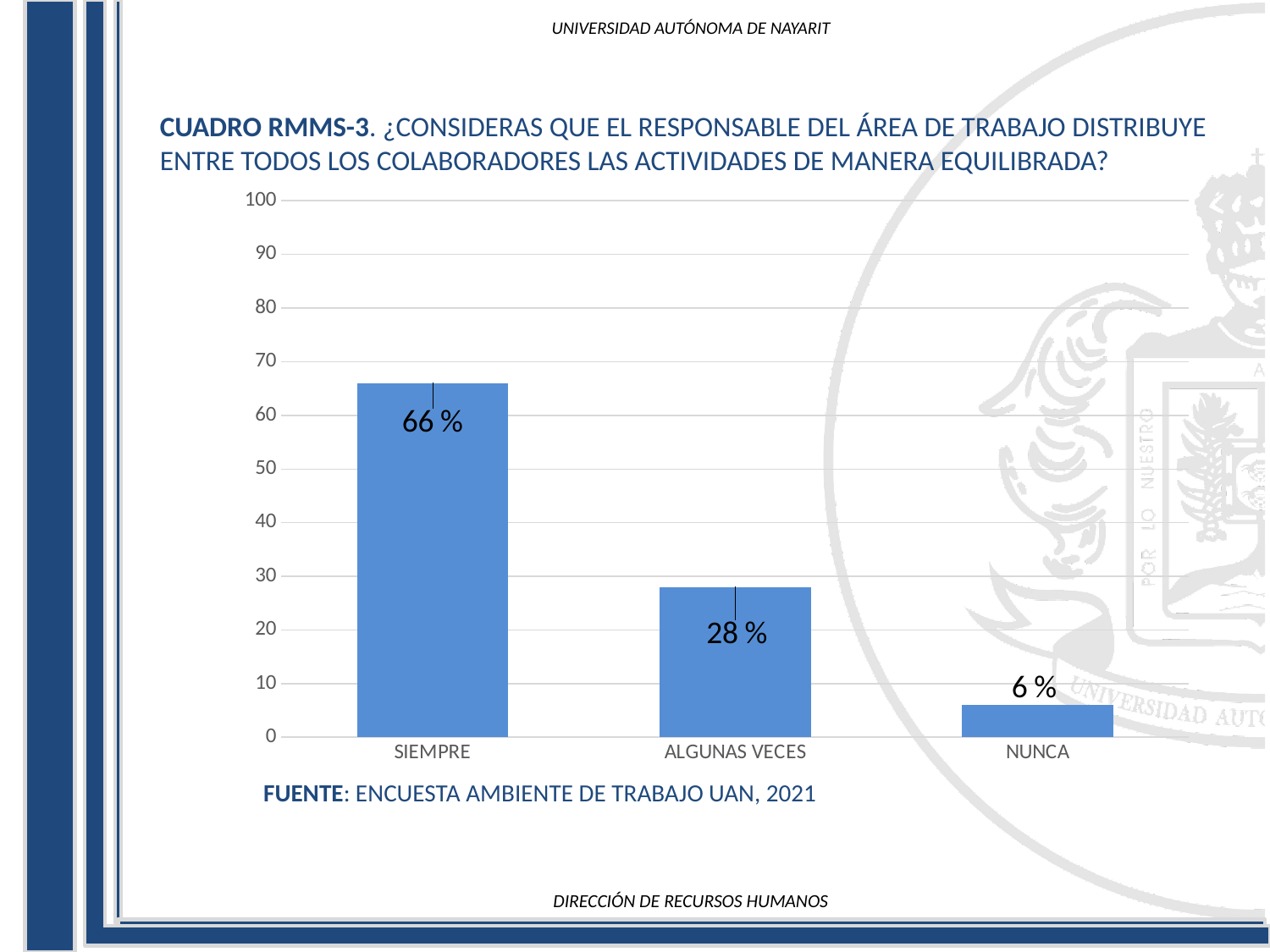
What is the value for SIEMPRE? 66 % What is the difference between the values for ALGUNAS VECES and NUNCA? 22 % Which is larger, the value for ALGUNAS VECES or the value for NUNCA? ALGUNAS VECES What is the value for ALGUNAS VECES? 28 % Which category has the lowest value? NUNCA Which category has the highest value? SIEMPRE What is the value for NUNCA? 6 % Is the value for SIEMPRE greater or less than 60? greater How many categories are shown on the x axis? 3 What source is cited below the chart? ENCUESTA AMBIENTE DE TRABAJO UAN, 2021 What is the difference between the values for SIEMPRE and ALGUNAS VECES? 38 % What kind of chart is shown on the slide? bar chart